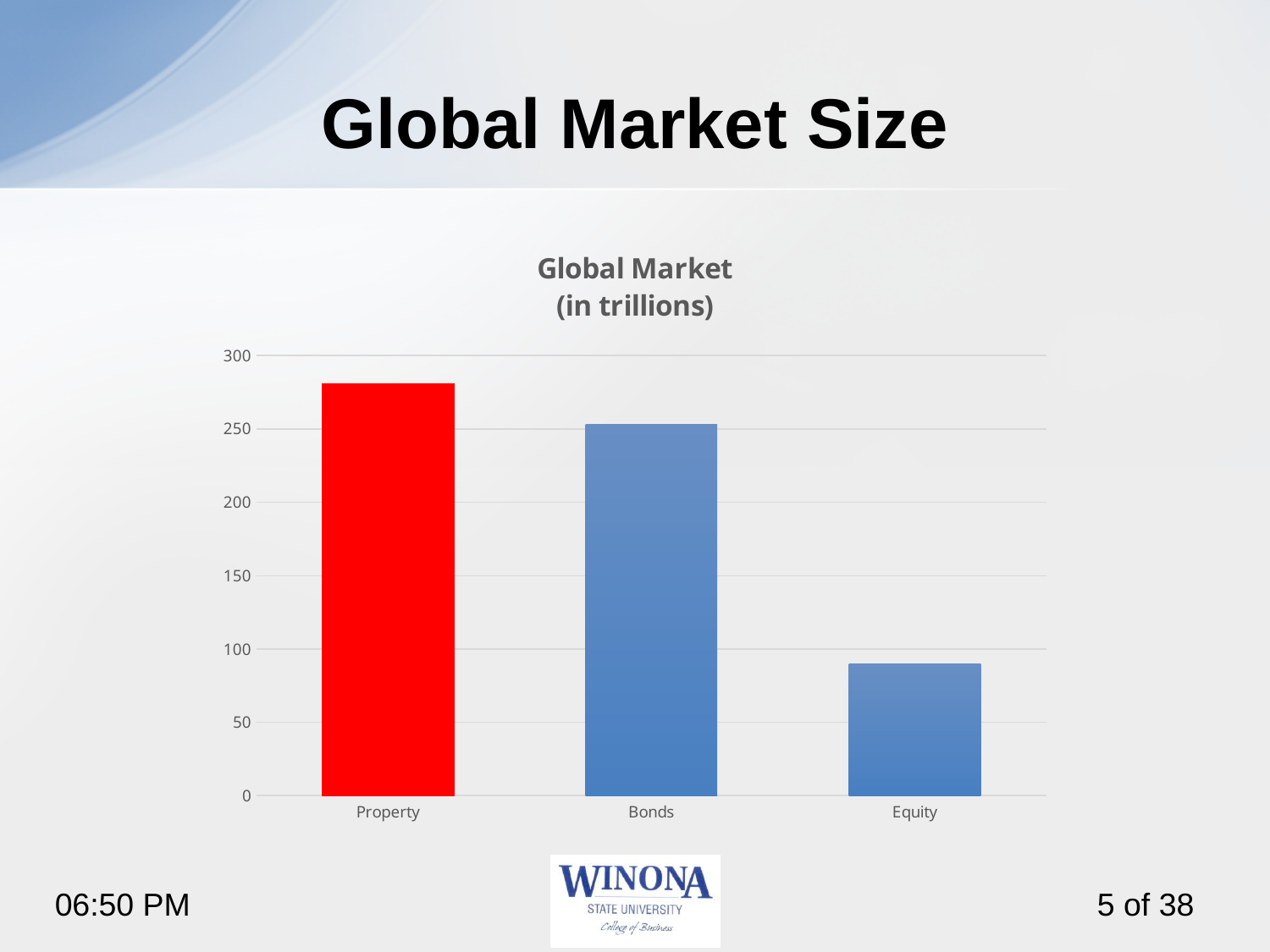
What kind of chart is shown on the slide? bar chart Do the values rise or fall moving from left to right along the x axis? fall What colour is the bar for Property? red Which category has the highest value? Property Is the value for Equity greater or less than 100? less Which category has the lowest value? Equity Is the value for Property greater or less than 250? greater Which is larger, the value for Bonds or the value for Equity? Bonds Is the value for Bonds greater or less than 200? greater How many categories are plotted in the chart? 3 Which is larger, the value for Property or the value for Bonds? Property What is the title of the chart? Global Market (in trillions)